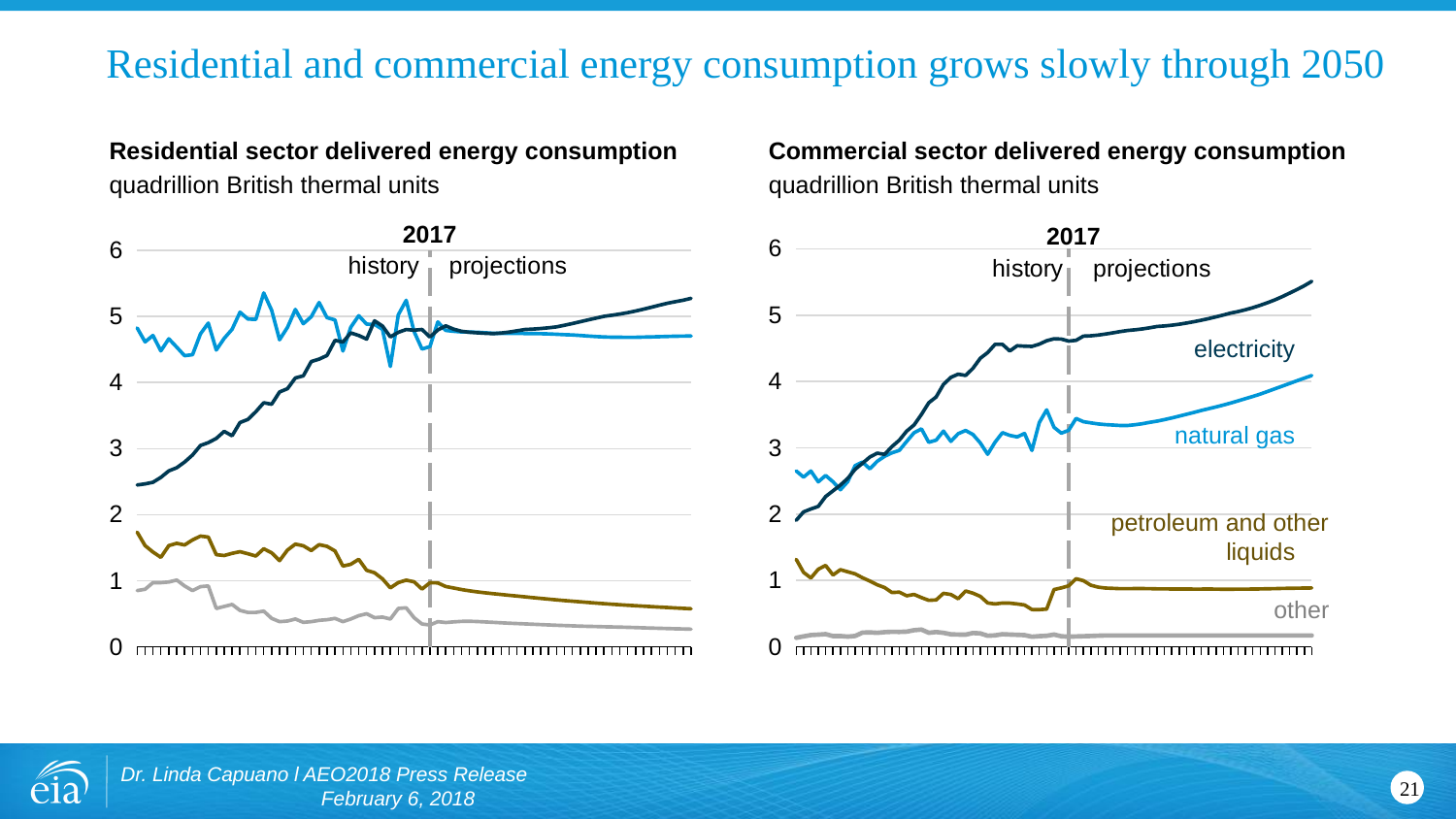
In the Commercial sector chart, which is larger at the end of the projections, electricity or natural gas? electricity In the Residential sector chart, is the value of the dark blue line at the end of the projections greater or less than 5? greater In the Commercial sector chart, is the value for natural gas at the end of the projections greater or less than 3? greater What year does the dashed vertical line separating history from projections mark in both charts? 2017 In the Commercial sector chart, does the electricity line rise or fall over the projection period? rise In the Commercial sector chart, is the value for petroleum and other liquids at the end of the projections greater or less than 1? less What kind of chart is the Residential sector delivered energy consumption chart? line chart How many labeled series does the Commercial sector delivered energy consumption chart show? 4 In the Commercial sector chart, which series has the highest value at the end of the projection period? electricity In the Residential sector chart, does the brown line rise or fall over the projection period? fall In the Commercial sector chart, which series has the lowest value throughout the chart? other